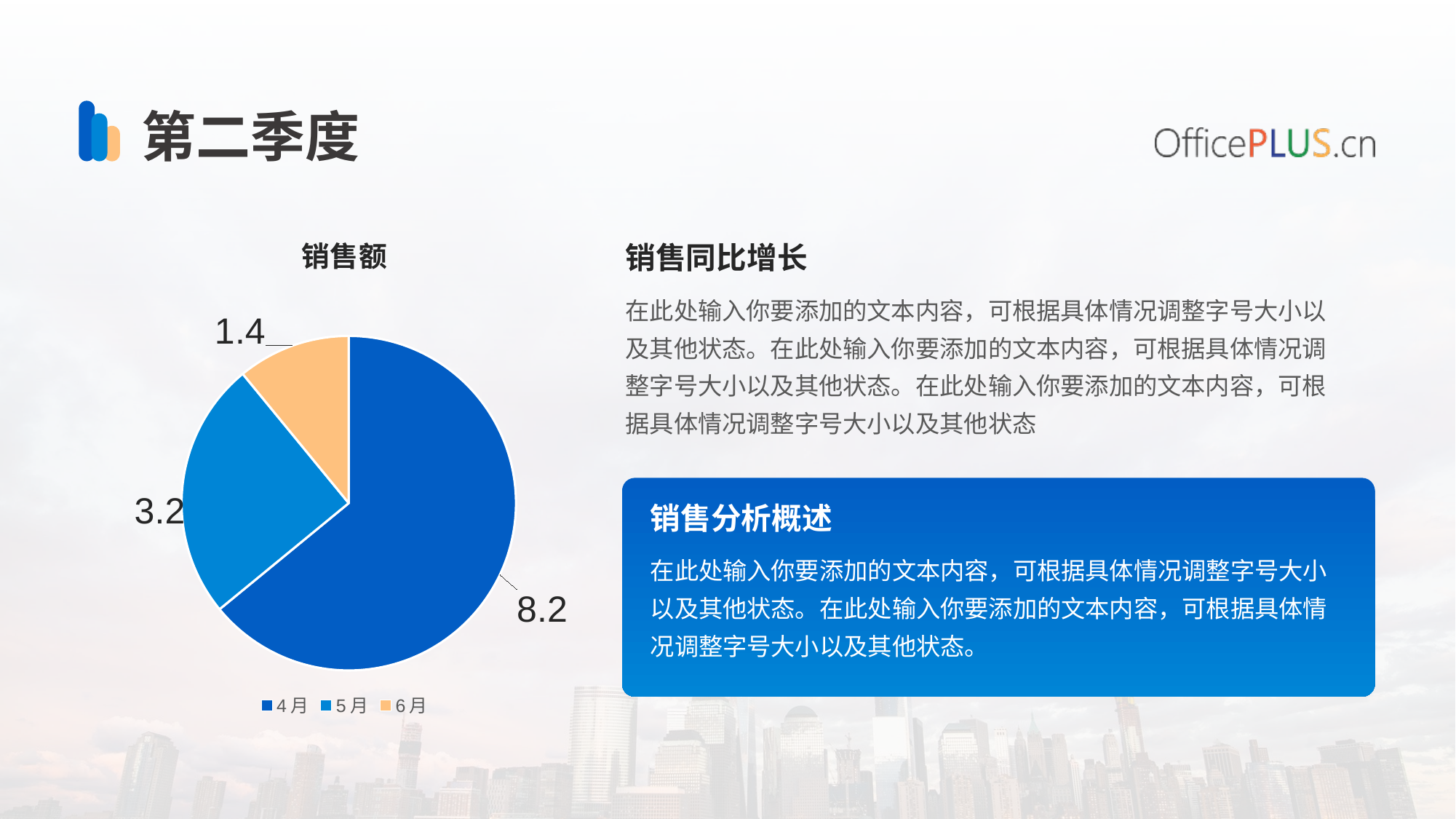
Which month has the smallest slice in the 销售额 pie chart? 6月 What is the difference between the values for 4月 and 5月 in the 销售额 pie chart? 5.0 What share of the 销售额 pie does 5月 represent? 25% Which month has the largest slice in the 销售额 pie chart? 4月 Which is larger in the 销售额 pie chart, the value for 5月 or the value for 6月? 5月 How many slices does the 销售额 pie chart have? 3 What is the value for 6月 in the 销售额 pie chart? 1.4 What is the title of the pie chart on the slide? 销售额 What is the difference between the values for 5月 and 6月 in the 销售额 pie chart? 1.8 What type of chart is shown under the title 销售额? Pie chart What is the value for 5月 in the 销售额 pie chart? 3.2 What is the value for 4月 in the 销售额 pie chart? 8.2